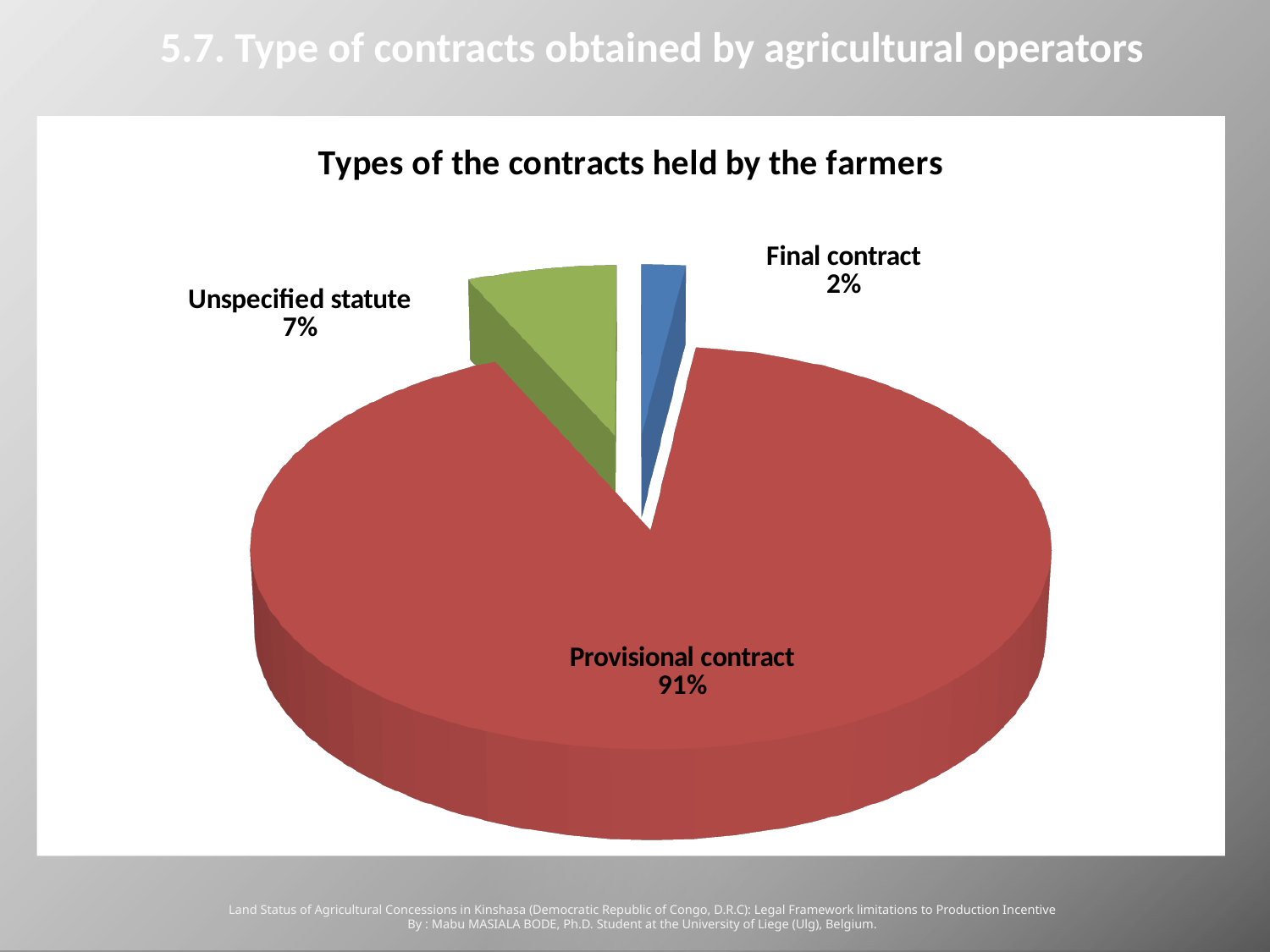
What colour is the Provisional contract slice? Red What is the difference between the Provisional contract share and the Unspecified statute share? 84% What is the difference between the Unspecified statute share and the Final contract share? 5% Which category has the largest slice of the pie? Provisional contract Which category has the smallest slice of the pie? Final contract What type of chart is shown on the slide? Pie chart What share of the pie is Unspecified statute? 7% How many categories are shown in the pie chart? 3 What is the chart's title? Types of the contracts held by the farmers Which is larger, the share for Unspecified statute or the share for Final contract? Unspecified statute What share of the pie is Final contract? 2% What share of the pie is Provisional contract? 91%